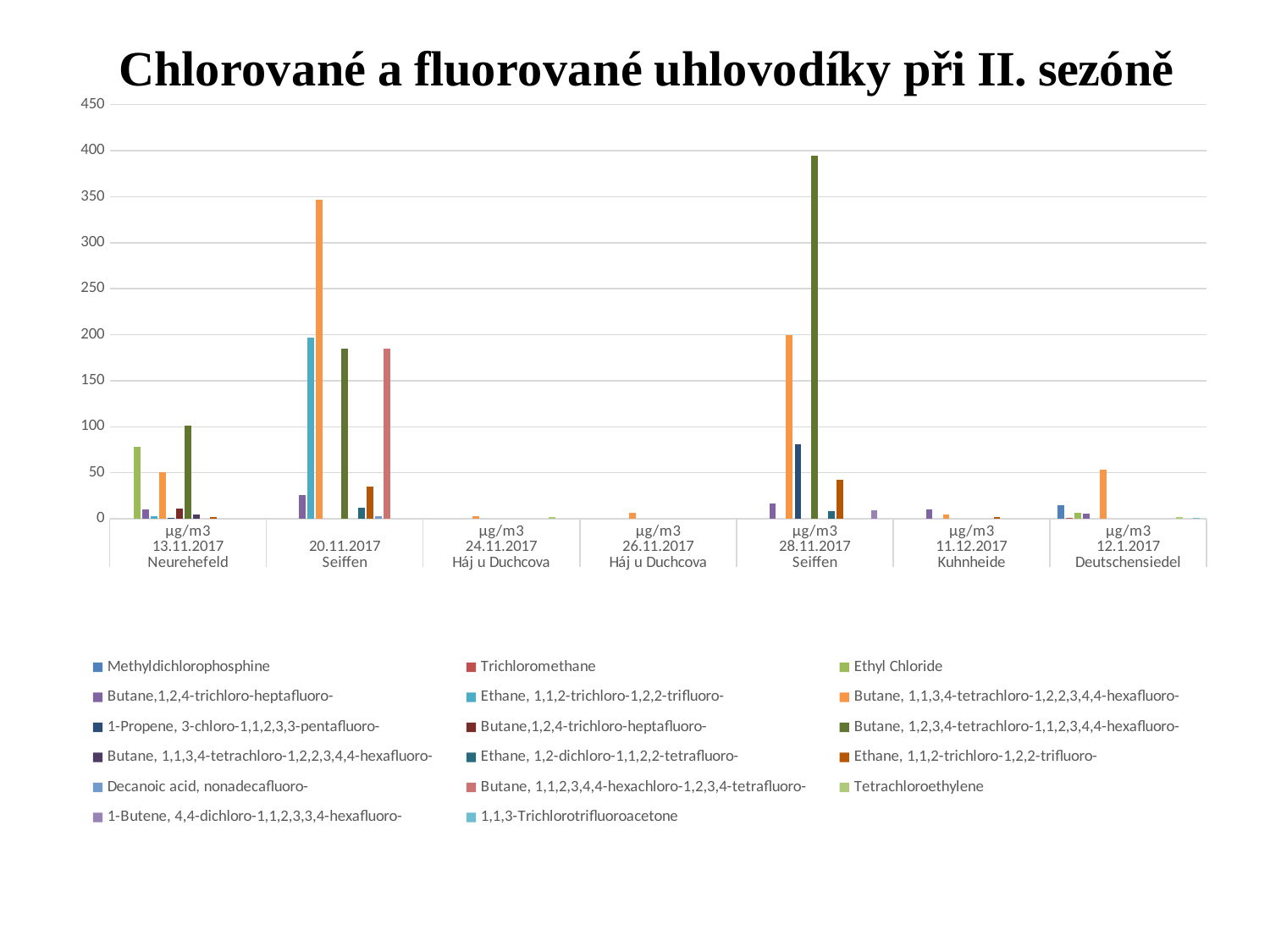
Is the value for Ethane, 1,1,2-trichloro-1,2,2-trifluoro- (light blue) at 20.11.2017 Seiffen greater or less than 150? greater What kind of chart is shown on the slide? bar chart What is the title of the chart? Chlorované a fluorované uhlovodíky při II. sezóně Which has the taller maximum bar: 20.11.2017 Seiffen or 28.11.2017 Seiffen? 28.11.2017 Seiffen How many categories (sampling dates/locations) are shown on the x axis? 7 Is the tallest bar in the 20.11.2017 Seiffen category greater or less than 300? greater Which has the taller maximum bar: 24.11.2017 Háj u Duchcova or 12.1.2017 Deutschensiedel? 12.1.2017 Deutschensiedel Is the value for Ethyl Chloride at 13.11.2017 Neurehefeld greater or less than 50? greater What is the highest value shown on the vertical axis? 450 Which category contains the tallest bar in the chart? 28.11.2017 Seiffen How many series does the legend list? 17